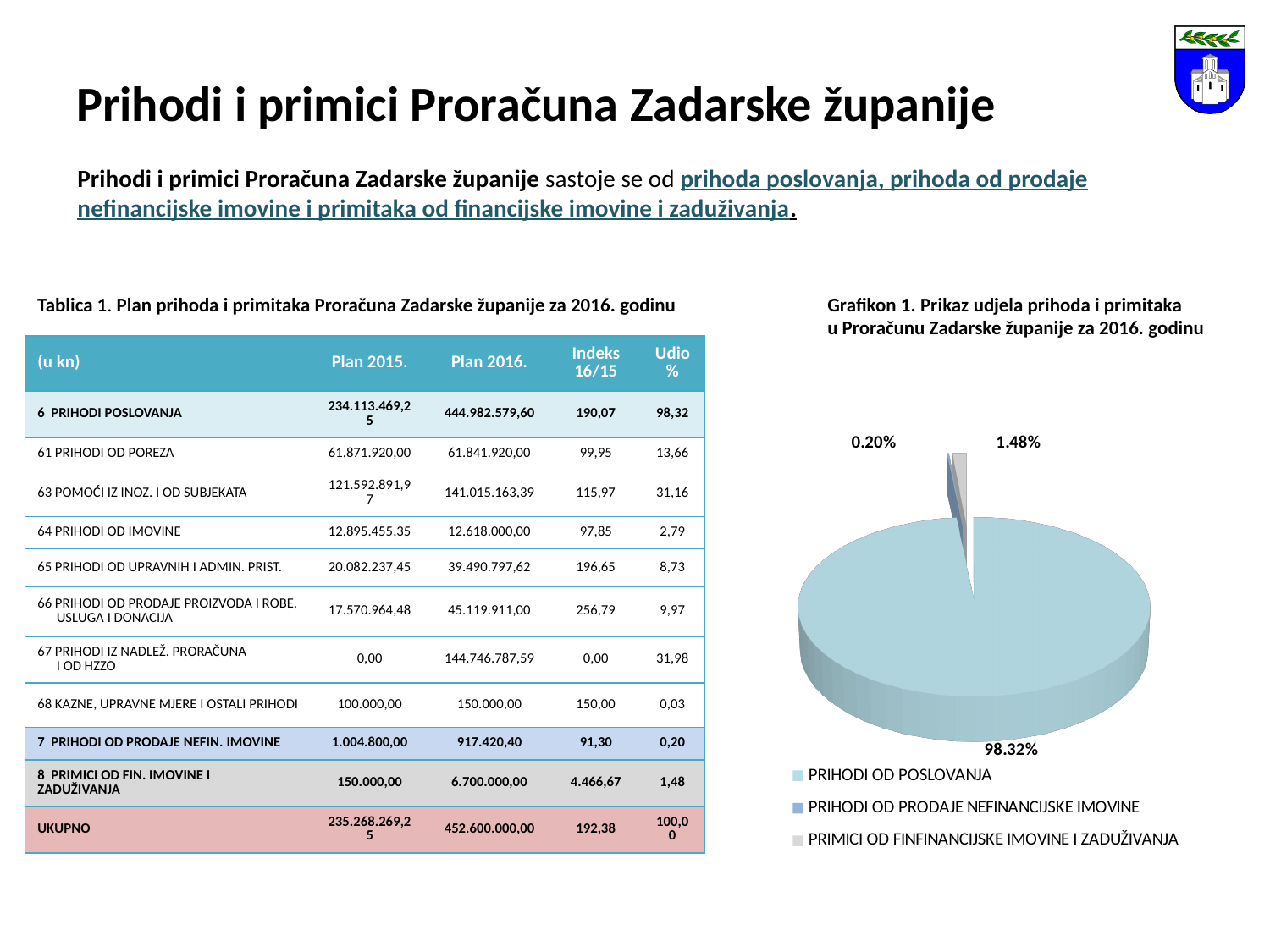
In the pie chart, what share does PRIHODI OD PRODAJE NEFINANCIJSKE IMOVINE have? 0.20% In the pie chart, what share does PRIHODI OD POSLOVANJA have? 98.32% Which category has the smallest slice in the pie chart? PRIHODI OD PRODAJE NEFINANCIJSKE IMOVINE What kind of chart is Grafikon 1 on the slide? pie chart Which legend entry in the pie chart is shown in grey? PRIMICI OD FINFINANCIJSKE IMOVINE I ZADUŽIVANJA In the pie chart, which is larger: the slice for PRIMICI OD FINFINANCIJSKE IMOVINE I ZADUŽIVANJA or the slice for PRIHODI OD PRODAJE NEFINANCIJSKE IMOVINE? PRIMICI OD FINFINANCIJSKE IMOVINE I ZADUŽIVANJA How many entries does the legend of the pie chart list? 3 In the pie chart, what share does PRIMICI OD FINFINANCIJSKE IMOVINE I ZADUŽIVANJA have? 1.48% Which category has the largest slice in the pie chart? PRIHODI OD POSLOVANJA How many slices does the pie chart have? 3 In the pie chart, what is the difference in percentage points between the 1.48% slice and the 0.20% slice? 1.28 What is the title of the pie chart on the slide? Grafikon 1. Prikaz udjela prihoda i primitaka u Proračunu Zadarske županije za 2016. godinu